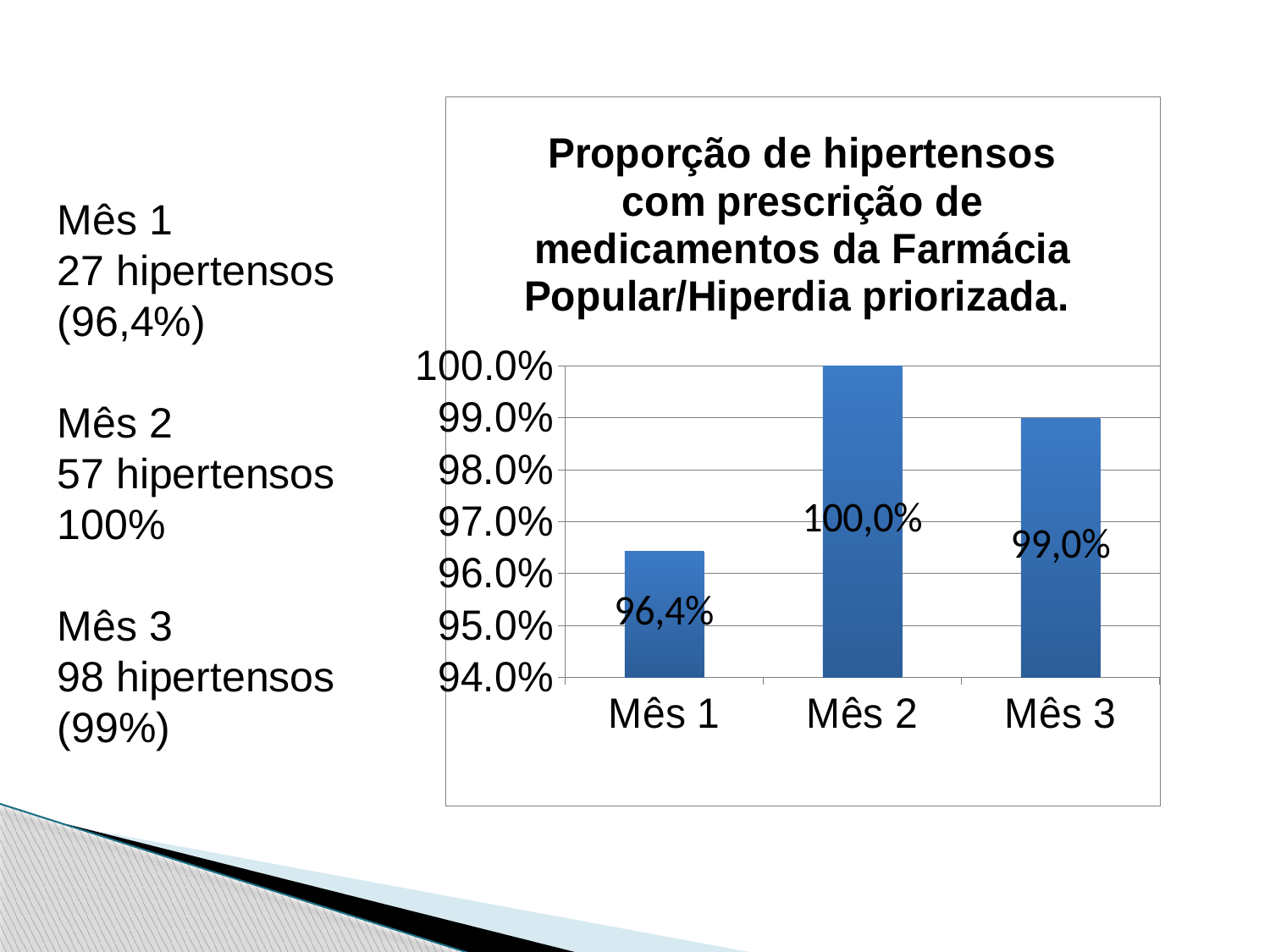
How many categories are shown on the x axis? 3 What kind of chart is shown? bar chart Which month has the lowest value? Mês 1 What is the title of the chart? Proporção de hipertensos com prescrição de medicamentos da Farmácia Popular/Hiperdia priorizada. Is the value for Mês 1 greater or less than 97.0%? less Which is larger, the value for Mês 2 or the value for Mês 3? Mês 2 What is the difference between the values for Mês 3 and Mês 1? 2,6% Which month has the highest value? Mês 2 What is the difference between the values for Mês 2 and Mês 1? 3,6% What is the value for Mês 3? 99,0% What is the value for Mês 1? 96,4% What is the value for Mês 2? 100,0%